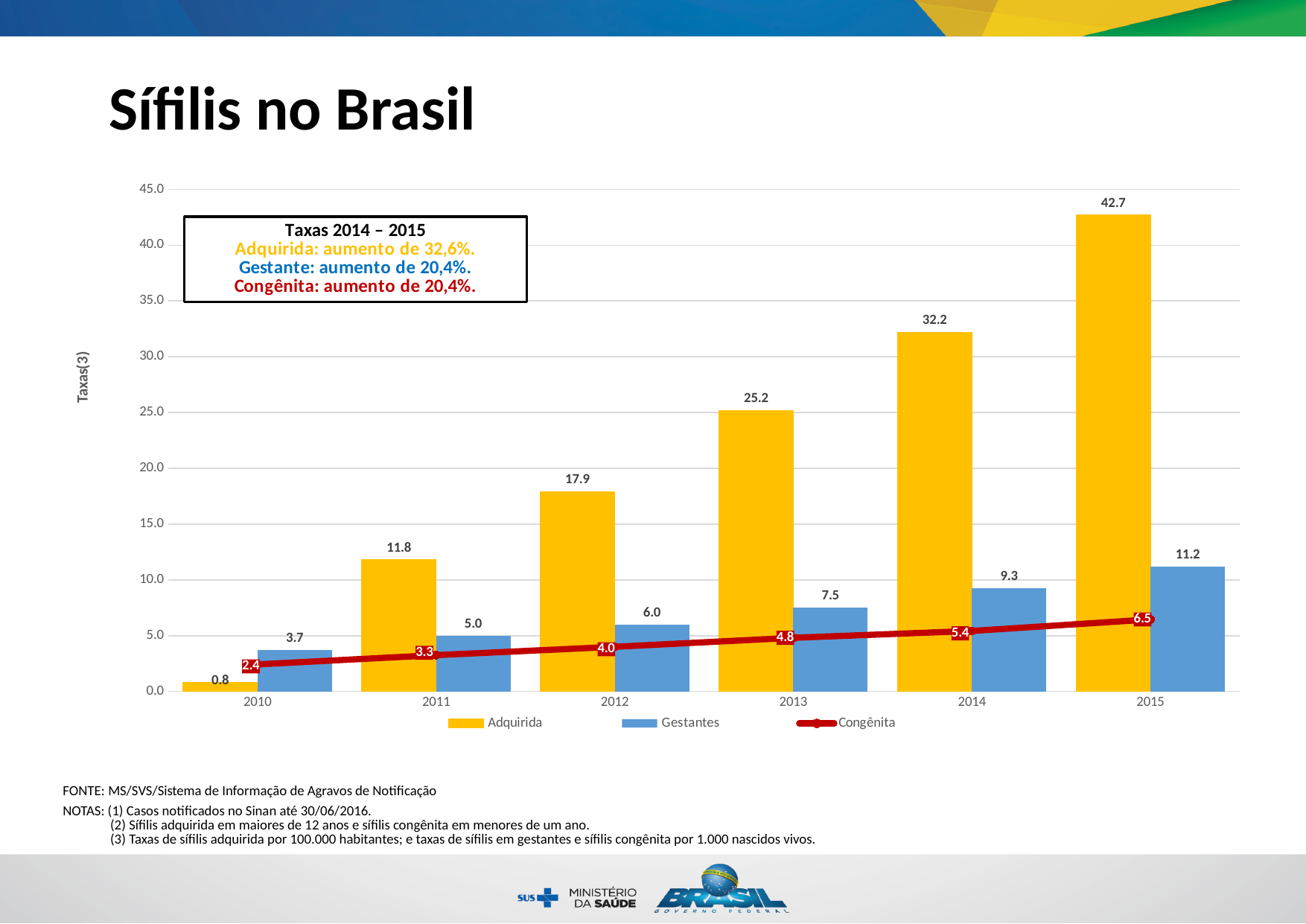
What is the label on the y axis? Taxas(3) In which year is the Adquirida value lowest? 2010 Which series is plotted as a red line? Congênita In which year is the Gestantes value highest? 2015 How many years are shown on the x axis? 6 Does the Congênita series rise or fall from 2010 to 2015? rise How many series does the legend list? 3 Which is larger in 2010: the Adquirida value or the Gestantes value? Gestantes What is the value for Gestantes in 2013? 7.5 What is the value for Congênita in 2012? 4.0 What is the difference between the Adquirida values for 2015 and 2014? 10.5 What is the value for Adquirida in 2015? 42.7